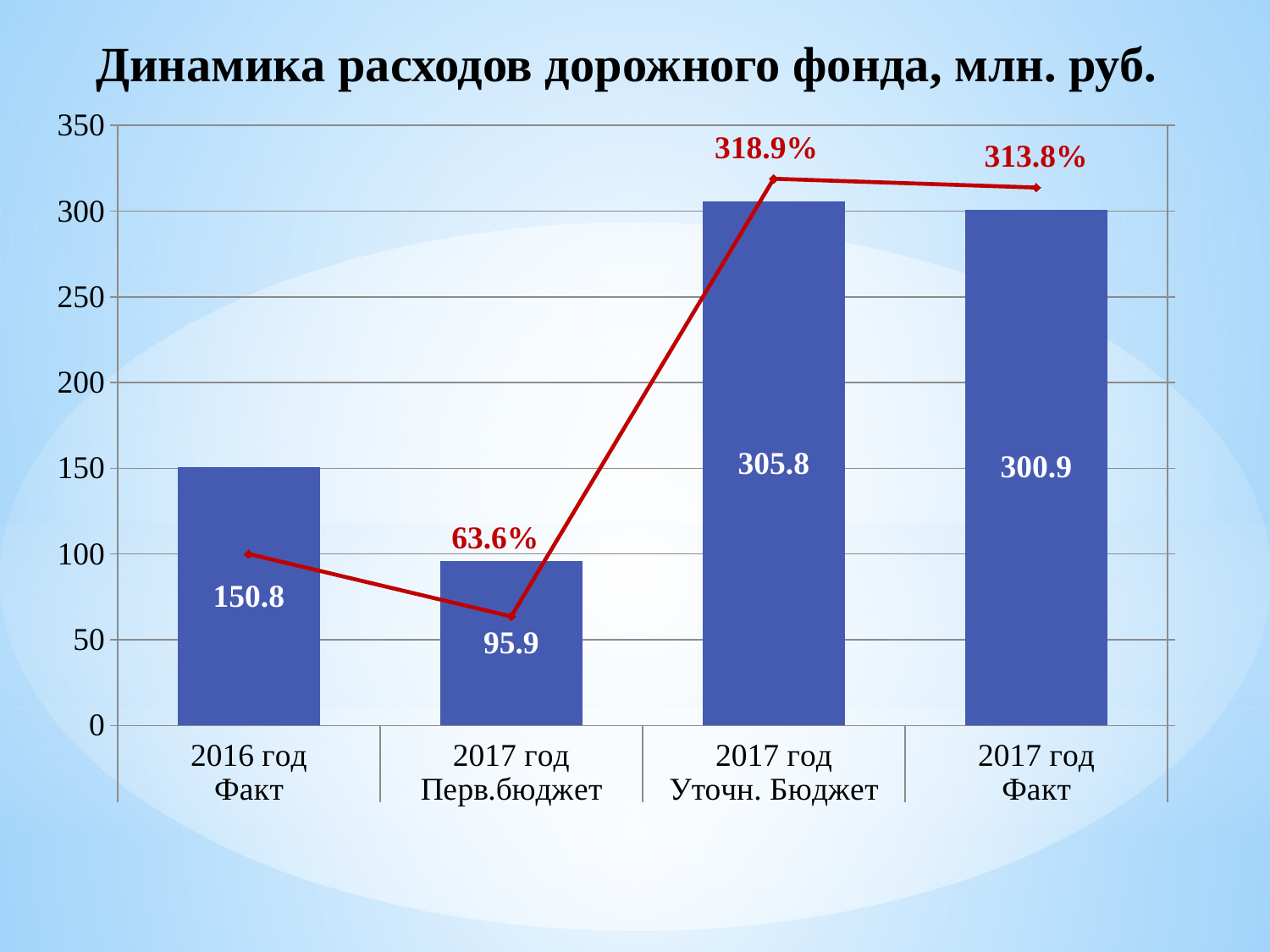
Which category has the lowest bar value? 2017 год Перв.бюджет Which is larger: the bar value for "2016 год Факт" or for "2017 год Перв.бюджет"? 2016 год Факт Is the bar value for "2017 год Факт" greater or less than 250? greater How many categories are shown on the x axis? 4 What percentage is shown on the line for "2017 год Факт"? 313.8% What is the value of the bar for "2017 год Уточн. Бюджет"? 305.8 What is the value of the bar for "2016 год Факт"? 150.8 What is the title of the chart? Динамика расходов дорожного фонда, млн. руб. Which category has the highest bar value? 2017 год Уточн. Бюджет What is the difference between the bar values for "2017 год Уточн. Бюджет" and "2017 год Факт"? 4.9 What is the value of the bar for "2017 год Перв.бюджет"? 95.9 What percentage is shown on the line for "2017 год Перв.бюджет"? 63.6%